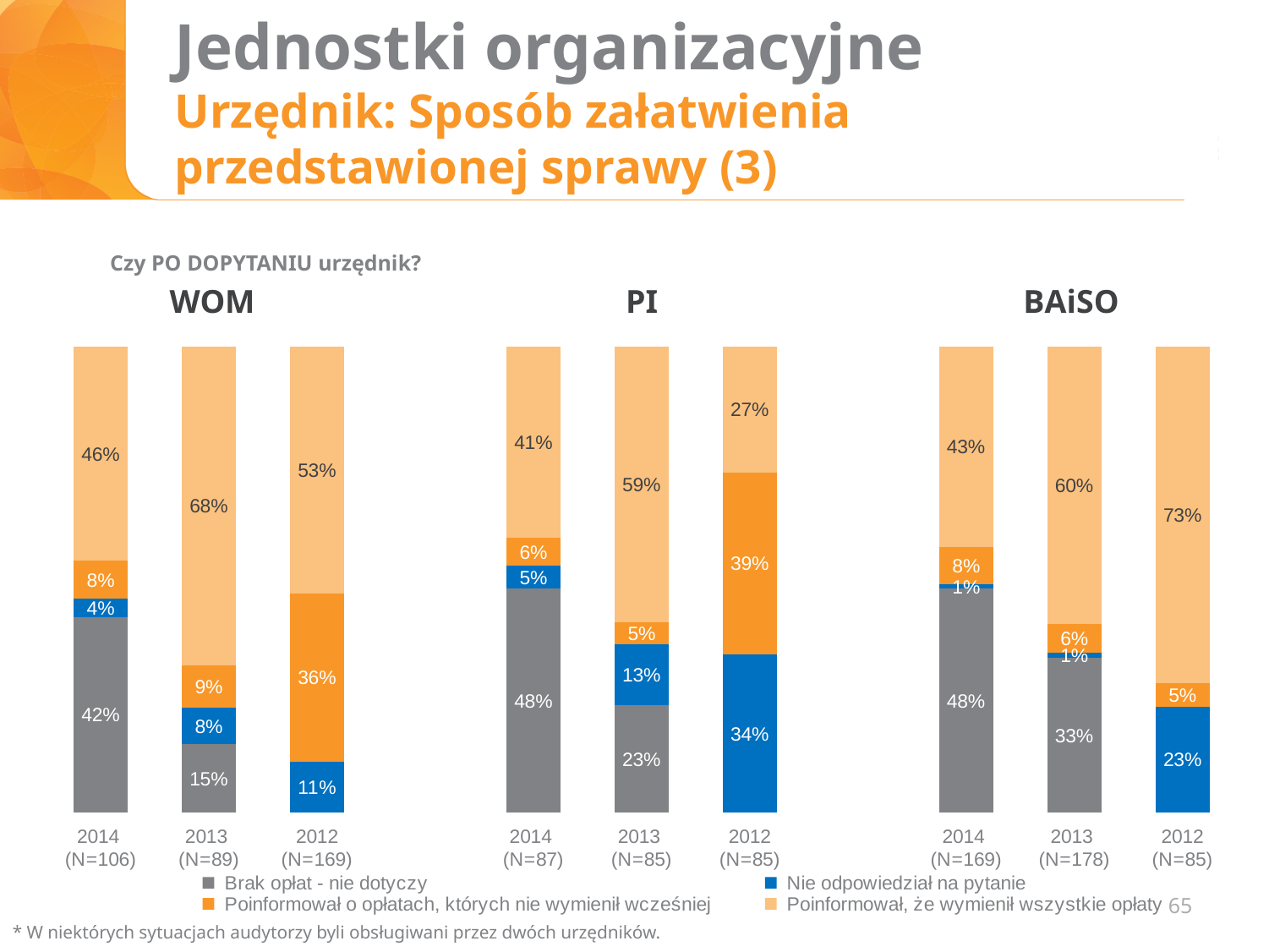
In the WOM chart, what is the difference between the 'Poinformował o opłatach, których nie wymienił wcześniej' values for 2012 and 2013? 27 percentage points In the PI chart, which year has the lowest value for 'Poinformował, że wymienił wszystkie opłaty'? 2012 In the WOM chart, which year has the highest value for 'Poinformował, że wymienił wszystkie opłaty'? 2013 In the BAiSO chart, does the 'Brak opłat - nie dotyczy' value rise or fall from 2014 to 2013? Fall What kind of chart is used for WOM, PI and BAiSO? Stacked bar chart How many bars does the BAiSO chart have? 3 In the PI chart, is the 'Nie odpowiedział na pytanie' value larger in 2012 or in 2013? 2012 In the BAiSO chart, what is the value for 'Poinformował, że wymienił wszystkie opłaty' in 2012 (N=85)? 73% How many series does the legend list? 4 In the BAiSO chart, what is the value for 'Nie odpowiedział na pytanie' in 2013 (N=178)? 1% In the WOM chart, what is the value for 'Brak opłat - nie dotyczy' in 2014 (N=106)? 42% In the PI chart, what is the value for 'Poinformował o opłatach, których nie wymienił wcześniej' in 2012 (N=85)? 39%